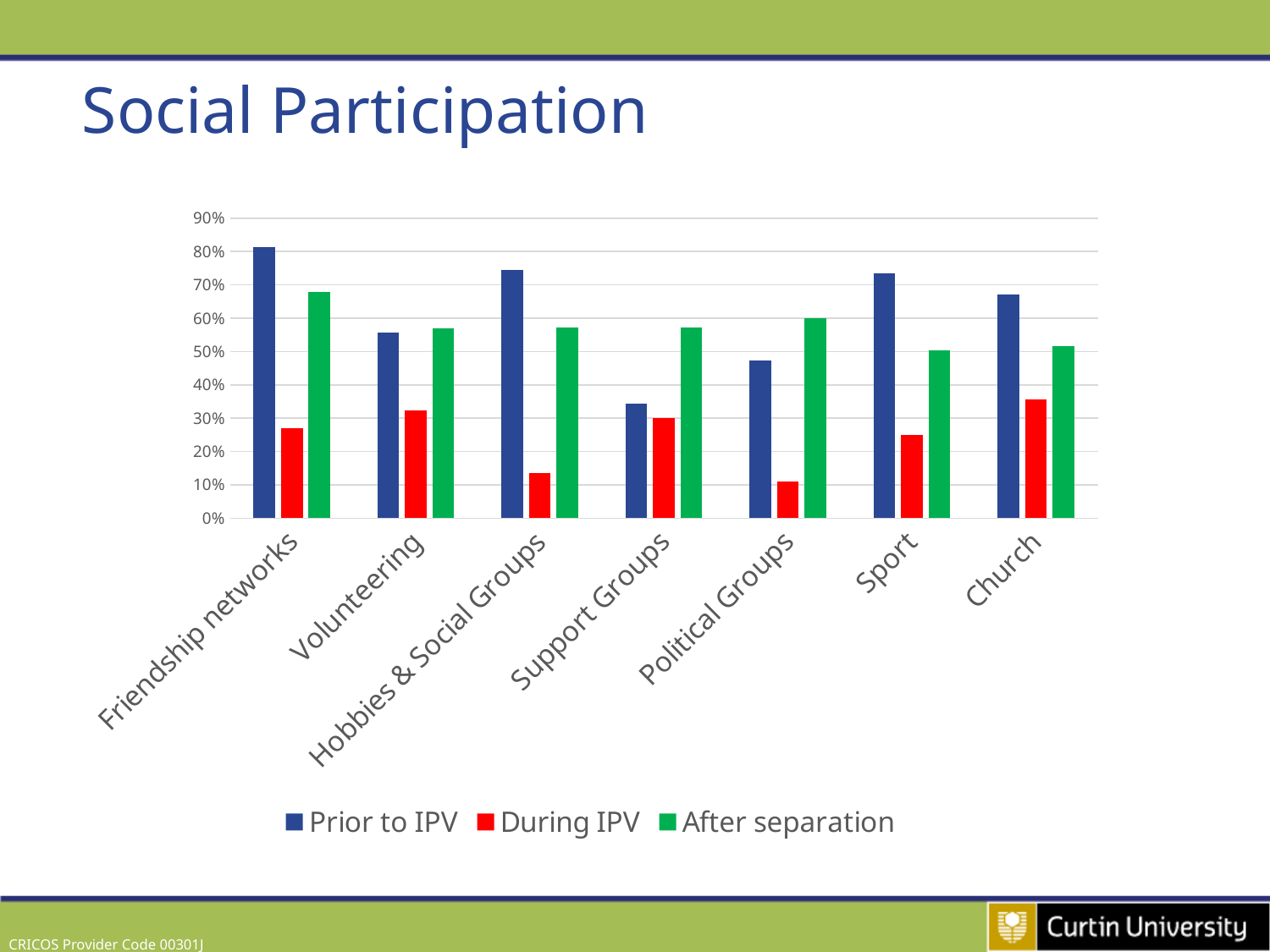
Is the Prior to IPV value for Friendship networks greater or less than 70%? greater Which category has the highest value for Prior to IPV? Friendship networks Which category has the lowest value for Prior to IPV? Support Groups What type of chart is shown on the slide? Bar chart How many categories are shown on the x axis? 7 Is the During IPV value for Hobbies & Social Groups greater or less than 20%? less For Church, which is larger: the Prior to IPV value or the After separation value? Prior to IPV How many series does the legend list? 3 For Political Groups, which is larger: the Prior to IPV value or the After separation value? After separation What colour represents the During IPV series? Red Which category has the highest value for After separation? Friendship networks Is the During IPV value for Sport greater or less than 30%? less